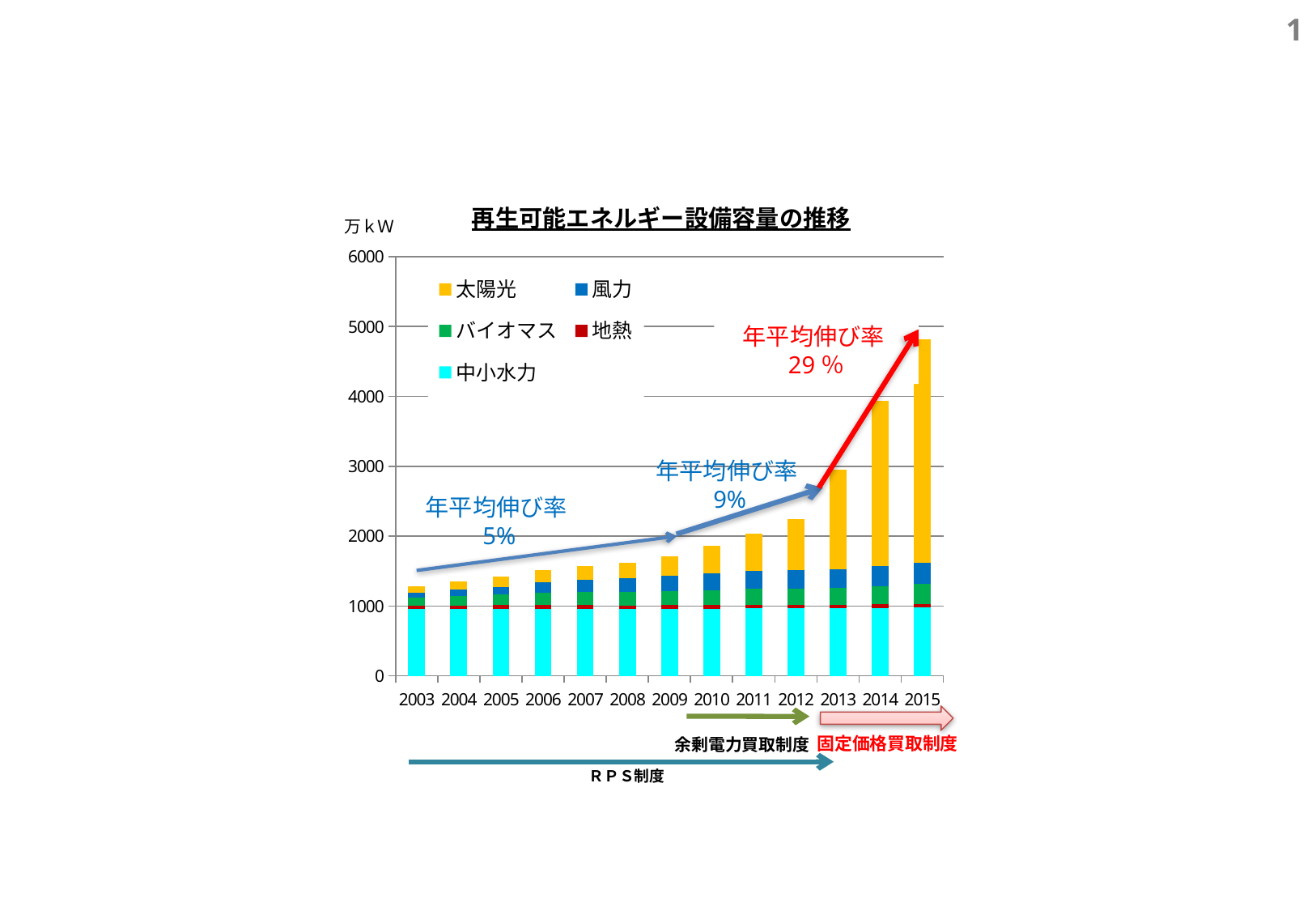
What annual average growth rate is annotated in red for the final period of the chart? 29% Which year has the lowest total bar? 2003 Which is larger, the total bar for 2010 or the total bar for 2014? 2014 How many years are shown on the x axis? 13 Is the total bar for 2012 greater or less than 2000? greater What is the title of the chart? 再生可能エネルギー設備容量の推移 Do the total bar values rise or fall from 2003 to 2015? rise Is the total bar for 2015 greater or less than 4000? greater Which year has the highest total bar? 2015 How many series does the legend list? 5 What kind of chart is shown on the slide? stacked bar chart Is the total bar for 2003 greater or less than 2000? less